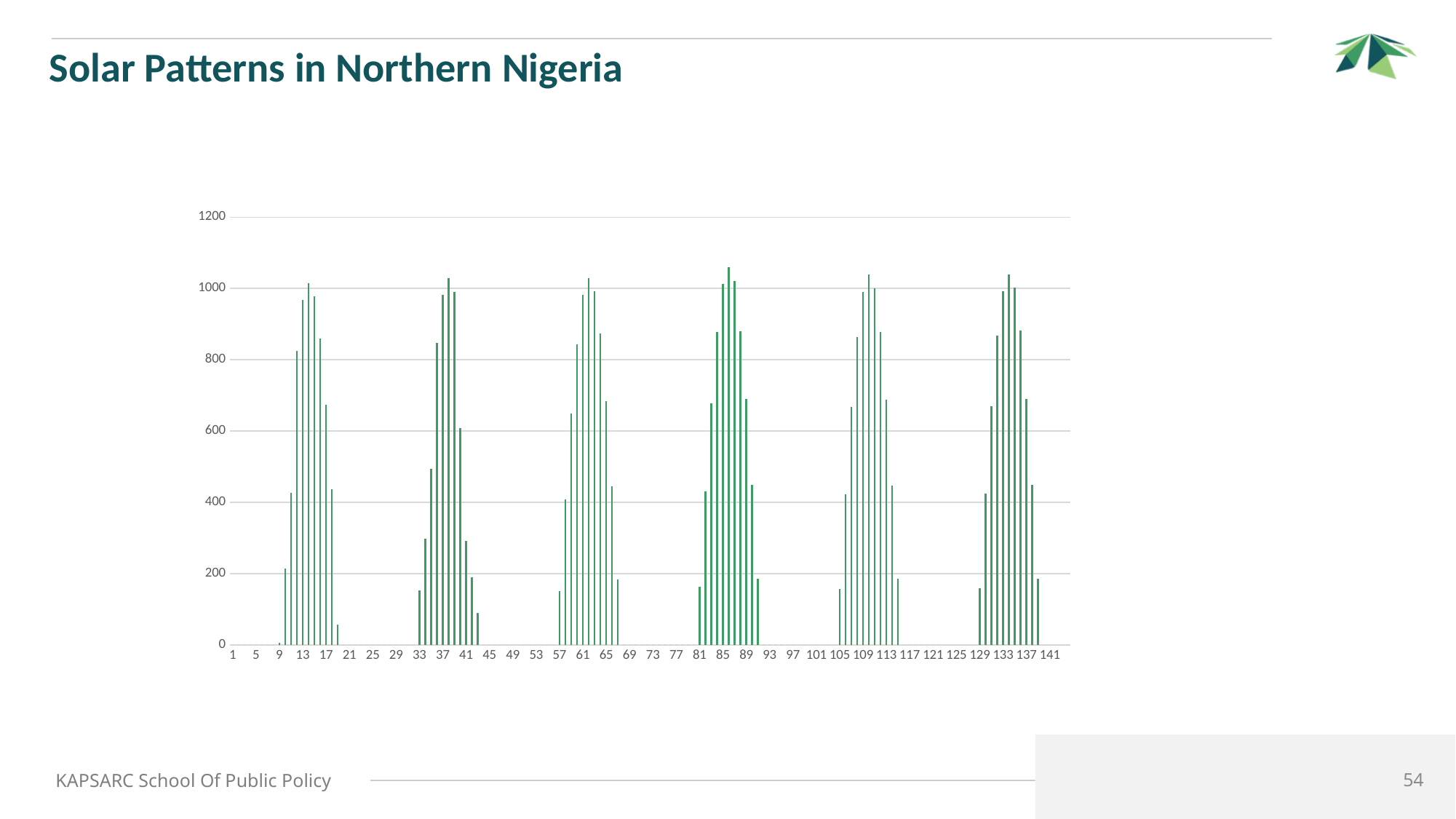
What kind of chart is shown on the slide? bar chart What is the title of the chart on the slide? Solar Patterns in Northern Nigeria Is the value at x = 25 greater or less than 200? less What is the highest value shown on the vertical axis? 1200 Within each cluster, do the bars rise and then fall, or fall and then rise, as x increases? rise and then fall Is the tallest bar in the chart greater or less than 1200? less Is the value at x = 17 greater or less than 600? greater How many separate clusters (groups) of bars appear in the chart? 6 What is the last label shown on the horizontal axis? 141 Which is larger, the value at x = 13 or the value at x = 21? x = 13